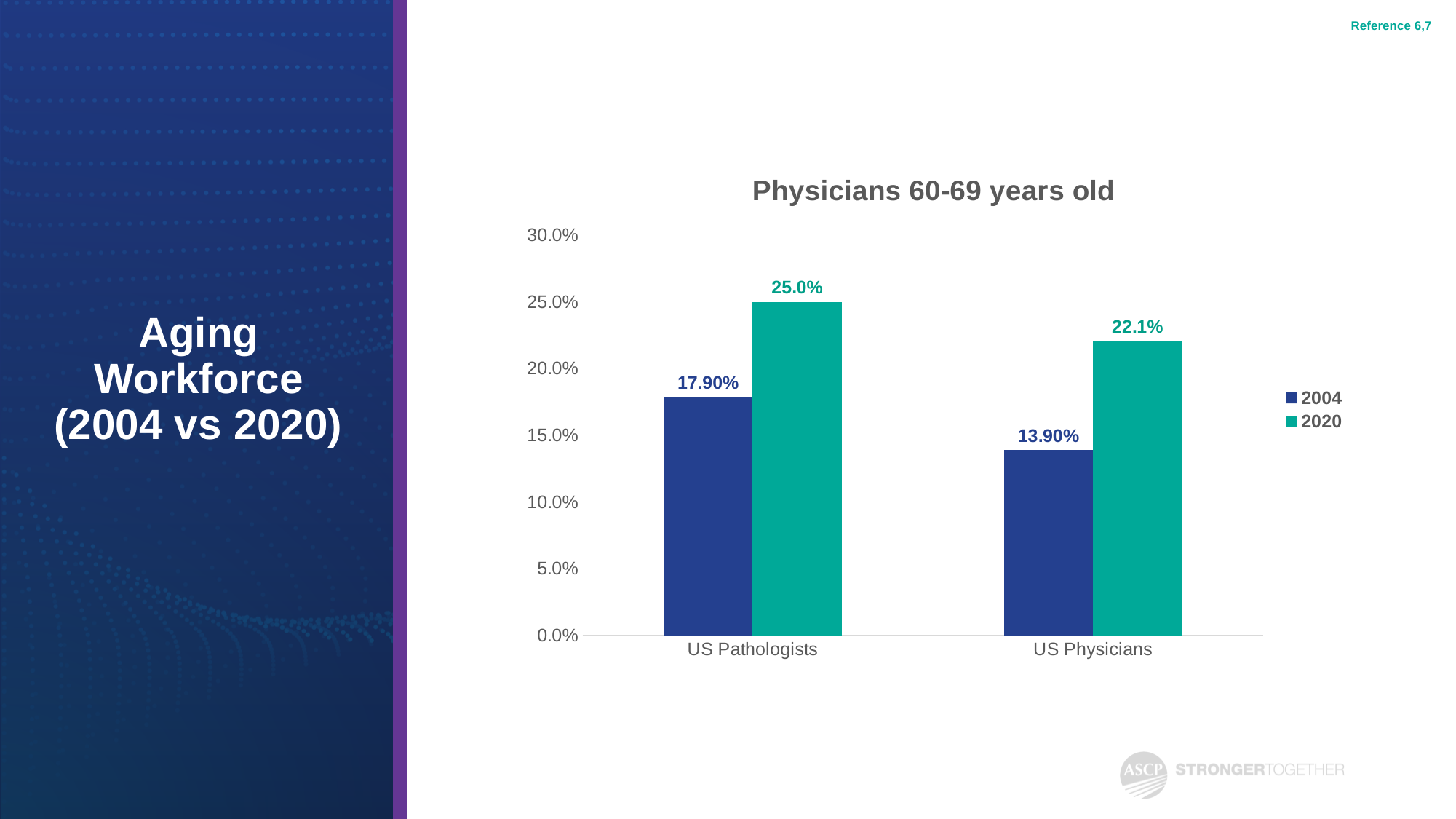
Which is larger: the 2020 value for US Pathologists or the 2020 value for US Physicians? US Pathologists What is the value for US Pathologists in 2004? 17.90% What is the value for US Pathologists in 2020? 25.0% Which bar has the lowest value in the chart? US Physicians, 2004 What is the value for US Physicians in 2004? 13.90% How many series does the legend list? 2 Is the 2004 value for US Physicians greater or less than 15.0%? less What is the difference between the 2020 and 2004 values for US Pathologists? 7.1 percentage points What is the value for US Physicians in 2020? 22.1% Which bar has the highest value in the chart? US Pathologists, 2020 What type of chart is shown on the slide? Bar chart How many categories are shown on the x axis? 2